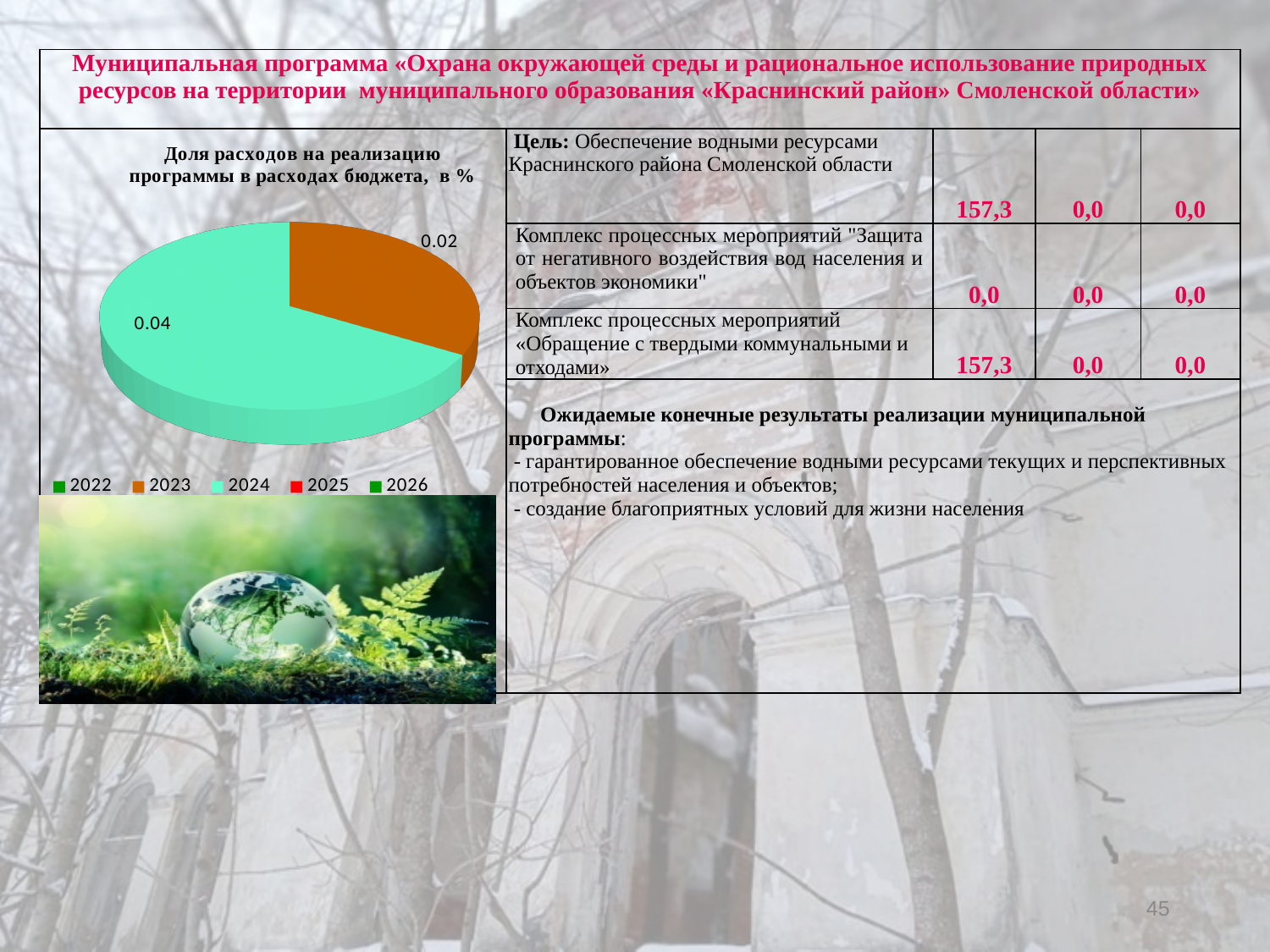
Which year has the largest slice in the pie chart? 2024 What is the value shown for 2024 in the pie chart? 0.04 What is the title of the pie chart? Доля расходов на реализацию программы в расходах бюджета, в % What colour is the slice for 2023 in the pie chart? orange What kind of chart is shown on the slide? pie chart How many slices with data labels are visible in the pie chart? 2 What is the difference between the values for 2024 and 2023 in the pie chart? 0.02 Is the value for 2024 larger or smaller than the value for 2023 in the pie chart? larger What is the value shown for 2023 in the pie chart? 0.02 Which of the two labelled slices in the pie chart is smaller, 2023 or 2024? 2023 How many entries does the legend of the pie chart list? 5